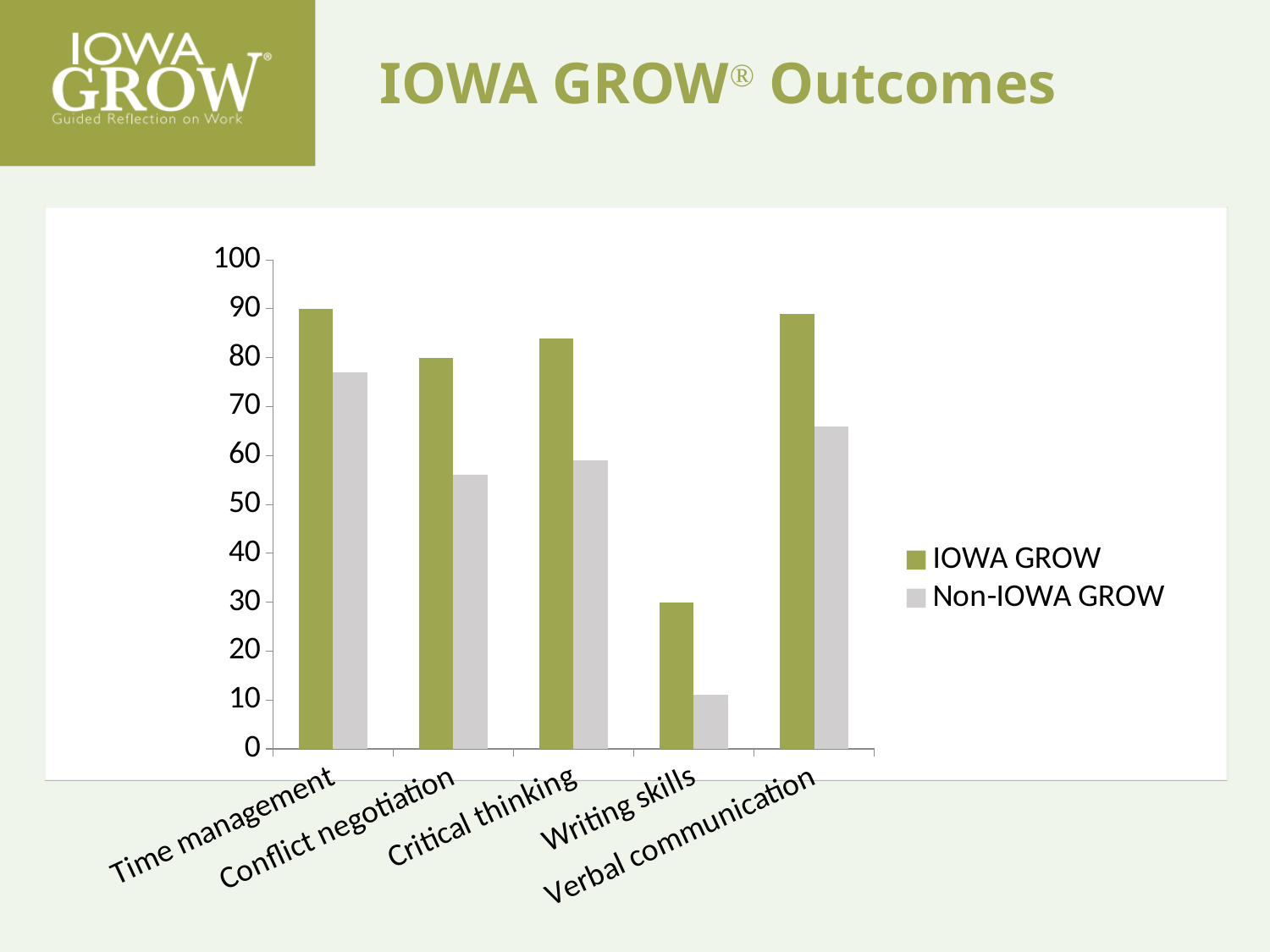
Is the IOWA GROW value for Critical thinking greater or less than 80? greater What is the title of the slide containing the chart? IOWA GROW® Outcomes Which series is shown in green bars? IOWA GROW For Writing skills, which series has the larger value, IOWA GROW or Non-IOWA GROW? IOWA GROW How many series does the legend list? 2 Which category has the lowest value for the IOWA GROW series? Writing skills Which category has the highest value for the Non-IOWA GROW series? Time management Is the Non-IOWA GROW value for Conflict negotiation greater or less than 60? less How many categories are shown on the x axis? 5 Which category has the lowest value for the Non-IOWA GROW series? Writing skills Is the Non-IOWA GROW value for Verbal communication greater or less than 70? less What kind of chart is shown on the slide? bar chart